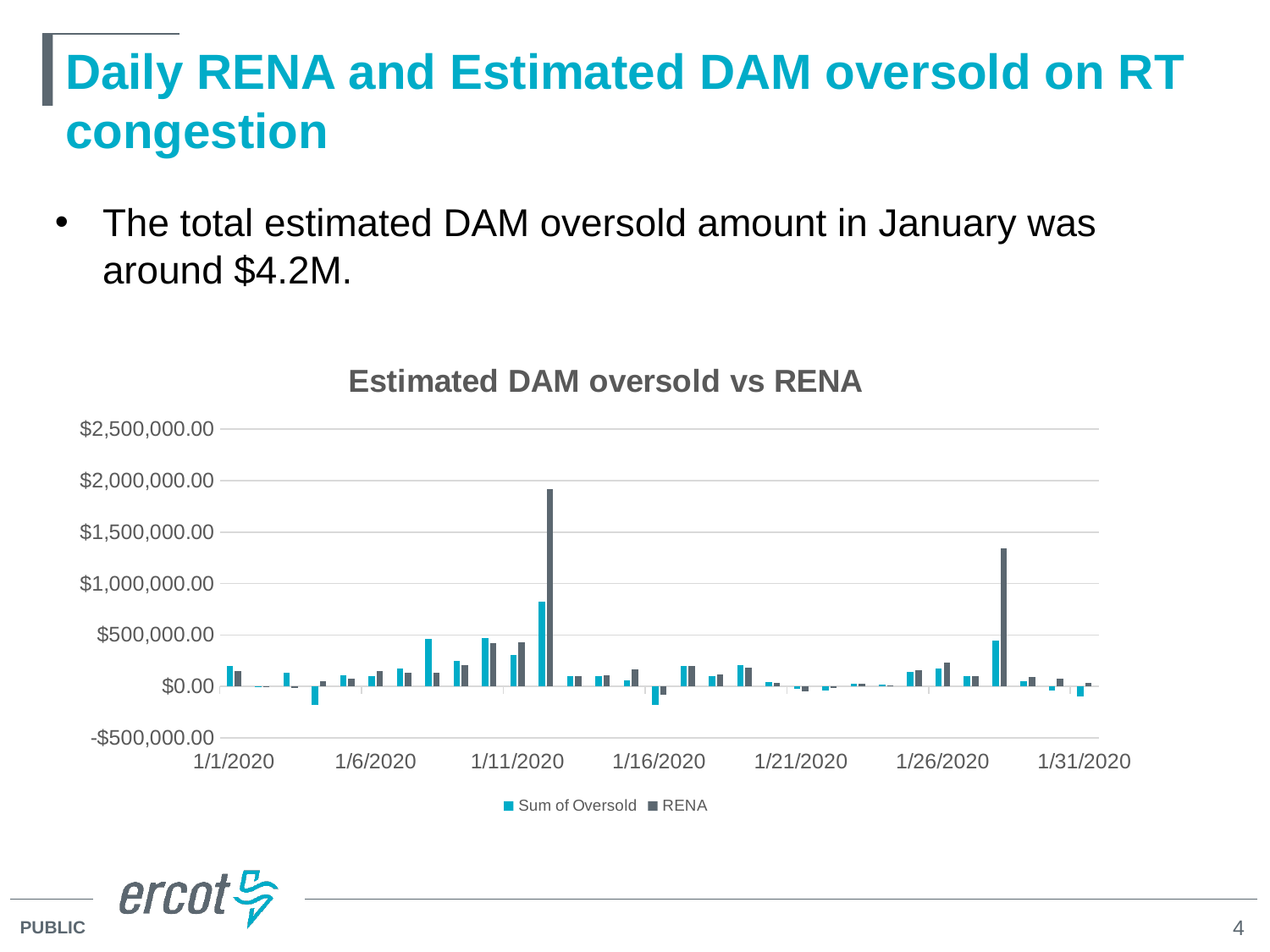
What kind of chart is shown on the slide? bar chart What is the title of the chart? Estimated DAM oversold vs RENA On the date with the tallest RENA bar, which is larger, the RENA value or the Sum of Oversold value? RENA What are the two series named in the chart legend? Sum of Oversold and RENA Does the chart show any negative Sum of Oversold values? yes Is the RENA value on 1/1/2020 greater or less than $500,000.00? less How many series does the legend of the chart list? 2 Is the tallest Sum of Oversold bar greater or less than $1,000,000.00? less Which series contains the tallest bar in the chart? RENA Is the tallest RENA bar greater or less than $1,500,000.00? greater